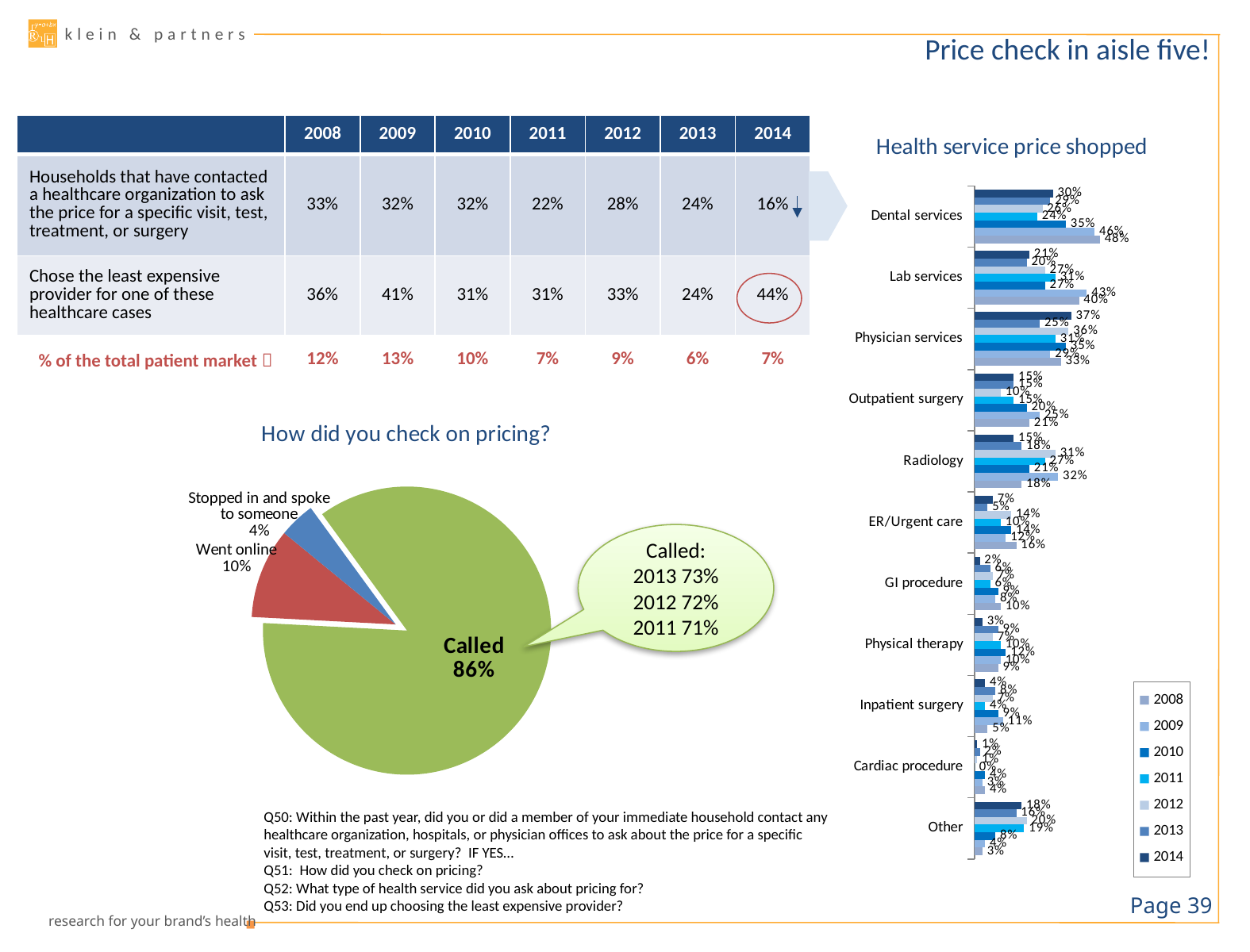
How many slices does the 'How did you check on pricing?' pie chart have? 3 In the 'How did you check on pricing?' pie chart, which slice is the smallest? Stopped in and spoke to someone In the 'How did you check on pricing?' pie chart, what share of respondents called? 86% What kind of chart is 'How did you check on pricing?'? pie chart How many series does the legend of the 'Health service price shopped' chart list? 7 In the 'Health service price shopped' chart, what is the difference between the 2008 and 2014 values for Dental services? 18 percentage points In the 'Health service price shopped' chart, what is the 2014 value for Dental services? 30% How many health service categories are shown in the 'Health service price shopped' chart? 11 In the 'Health service price shopped' chart, what is the 2008 value for Dental services? 48% In the 'How did you check on pricing?' pie chart, what share went online? 10% In the 'How did you check on pricing?' pie chart, which slice is the largest? Called What kind of chart is 'Health service price shopped'? bar chart